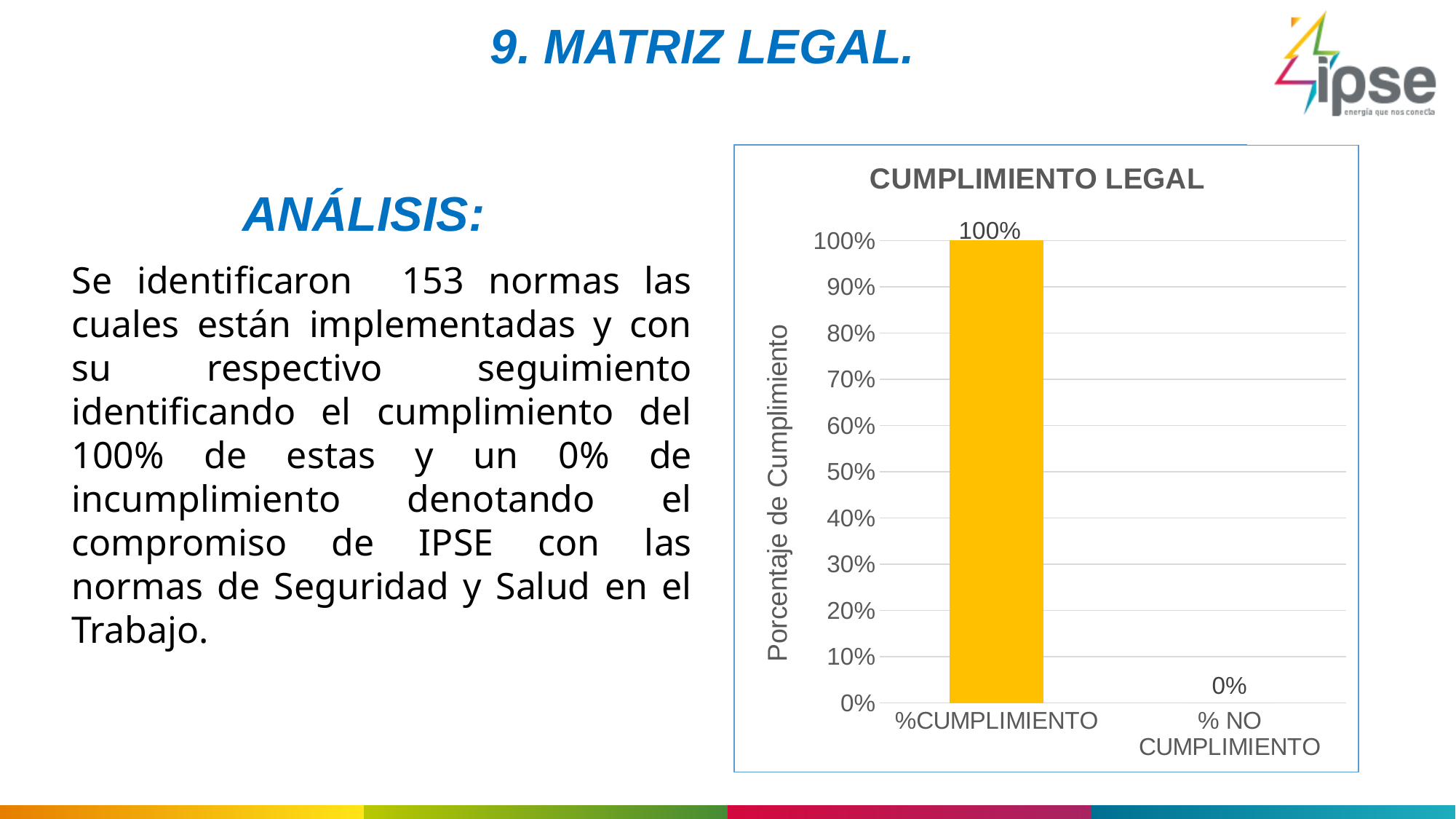
Which category has the highest value? %CUMPLIMIENTO Is the value for %CUMPLIMIENTO greater or less than 50%? greater What is the value for % NO CUMPLIMIENTO? 0% What is the title of the chart? CUMPLIMIENTO LEGAL Do the values rise or fall from left to right along the x axis? fall What is the value for %CUMPLIMIENTO? 100% Which is larger, the value for %CUMPLIMIENTO or the value for % NO CUMPLIMIENTO? %CUMPLIMIENTO How many categories are shown on the x axis of the chart? 2 What kind of chart is shown on the slide? bar chart What is the difference between the values for %CUMPLIMIENTO and % NO CUMPLIMIENTO? 100% Which category has the lowest value? % NO CUMPLIMIENTO What is the label of the vertical axis of the chart? Porcentaje de Cumplimiento